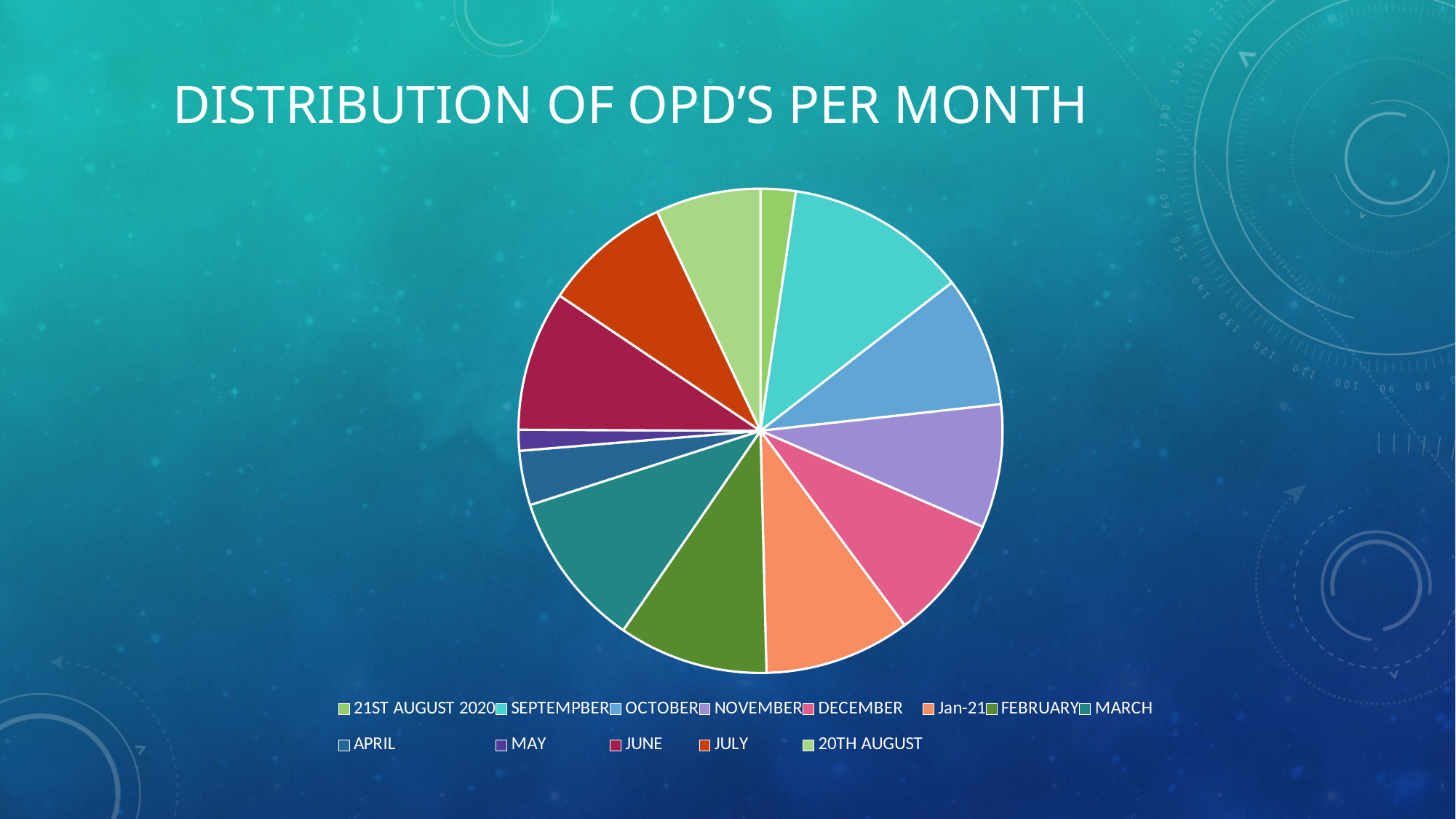
What kind of chart is shown on the slide? pie chart How many categories (slices) does the pie chart have? 13 What is the title of the chart? DISTRIBUTION OF OPD'S PER MONTH Which slice is larger, MARCH or 21ST AUGUST 2020? MARCH Which legend entry is listed first? 21ST AUGUST 2020 Which slice is larger, NOVEMBER or APRIL? NOVEMBER Which slice is larger, 20TH AUGUST or MAY? 20TH AUGUST How many data series does the chart plot? 1